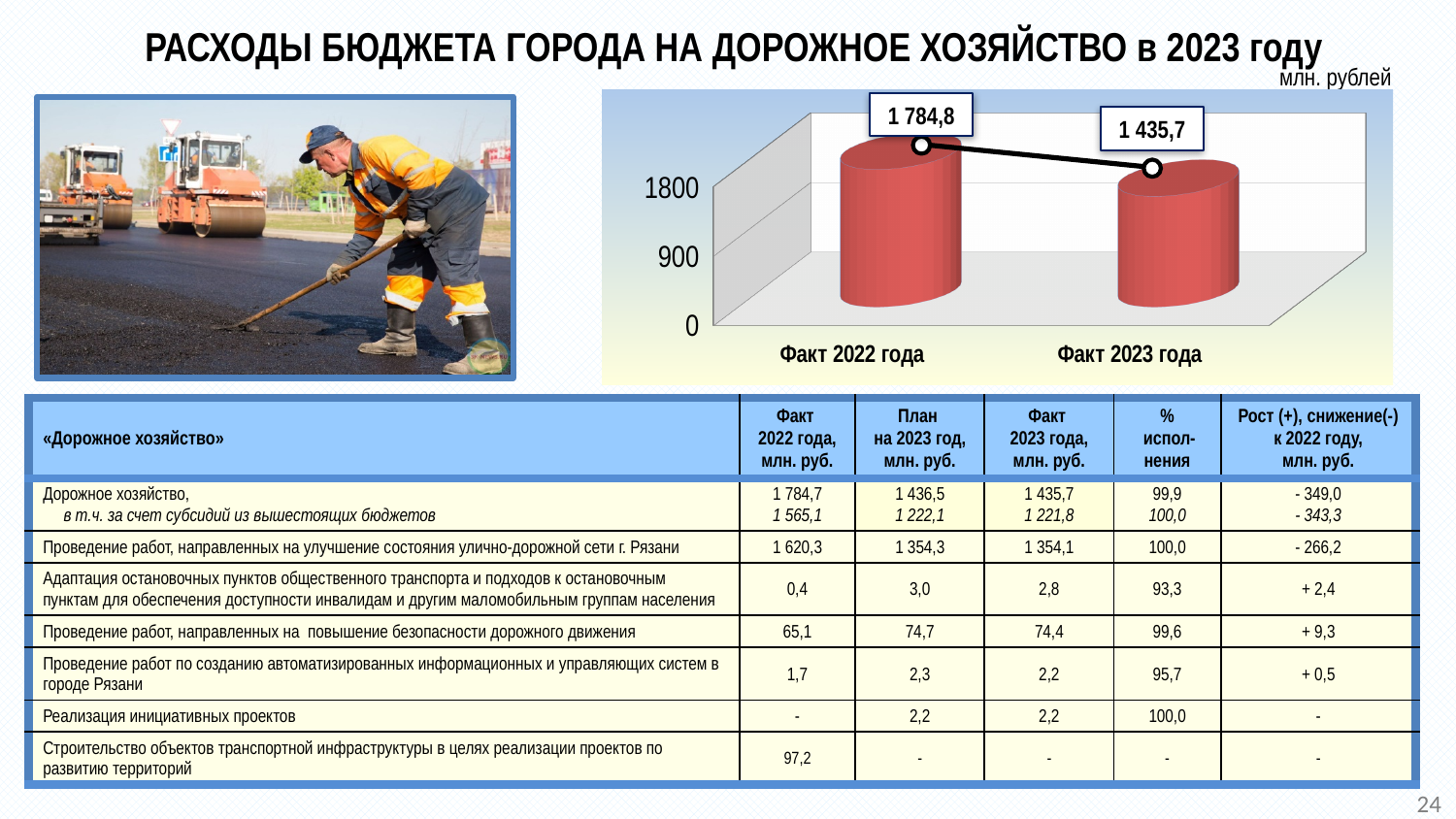
Which category on the chart has the lowest value? Факт 2023 года How many categories are plotted on the chart? 2 Is the value for «Факт 2023 года» greater or less than 1800? less What is the value shown for «Факт 2022 года» on the chart? 1 784,8 By how much does the value for «Факт 2022 года» exceed the value for «Факт 2023 года» on the chart? 349,1 Is the value for «Факт 2022 года» greater or less than 900? greater Which category on the chart has the highest value? Факт 2022 года In what units are the values on the chart expressed? млн. рублей Which is larger on the chart: the value for «Факт 2022 года» or for «Факт 2023 года»? Факт 2022 года What kind of chart is shown on the slide? bar chart Do the values on the chart rise or fall from «Факт 2022 года» to «Факт 2023 года»? fall What is the value shown for «Факт 2023 года» on the chart? 1 435,7